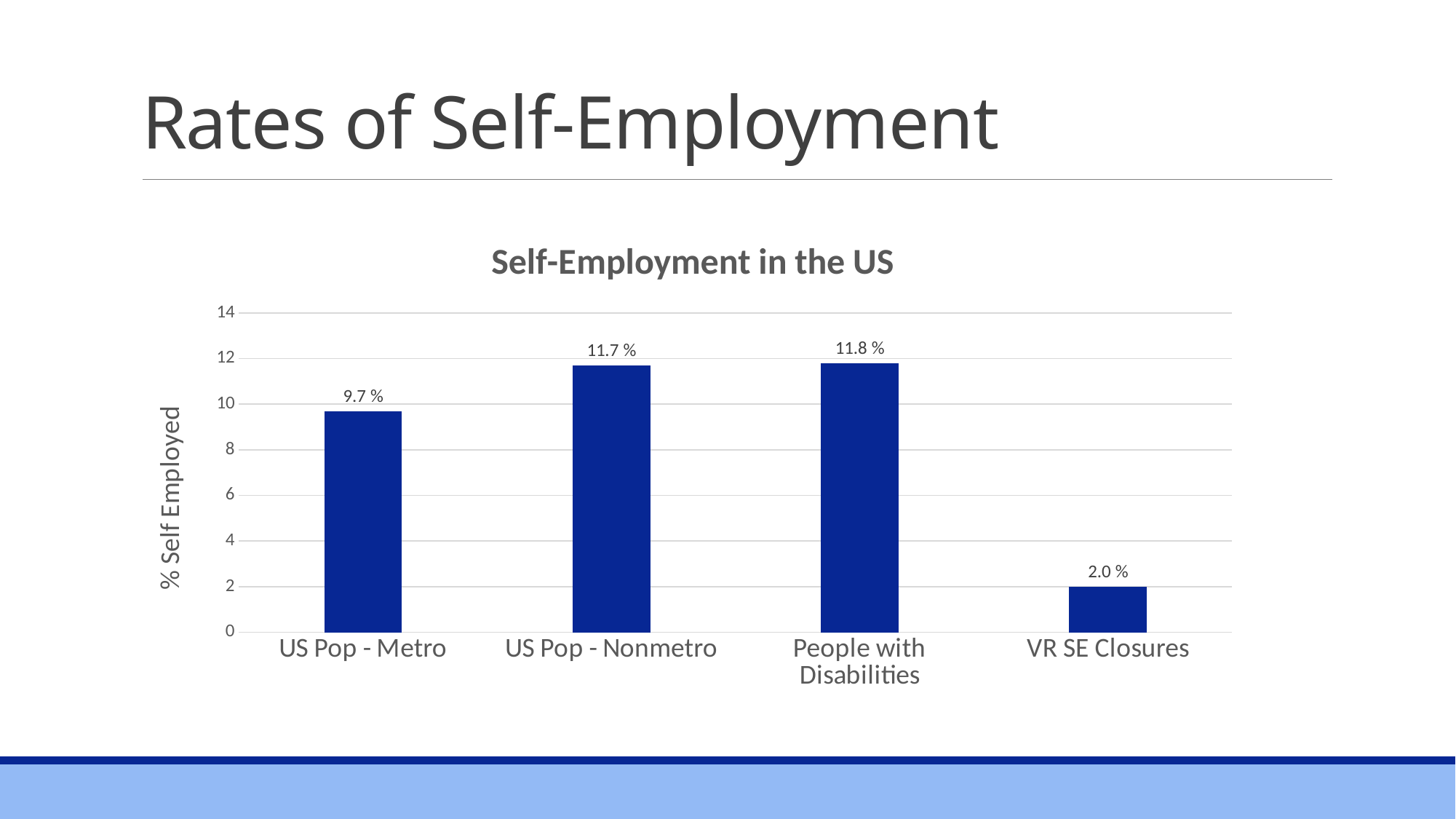
What is the value for People with Disabilities in the Self-Employment in the US chart? 11.8 % Which is larger, the value for US Pop - Metro or the value for US Pop - Nonmetro? US Pop - Nonmetro Which category has the lowest value in the Self-Employment in the US chart? VR SE Closures What kind of chart is shown on the slide? bar chart What is the value for VR SE Closures in the Self-Employment in the US chart? 2.0 % Is the value for VR SE Closures greater or less than 4? less What is the difference between the values for US Pop - Nonmetro and US Pop - Metro? 2.0 % How many categories are shown in the Self-Employment in the US chart? 4 What is the value for US Pop - Metro in the Self-Employment in the US chart? 9.7 % Which category has the highest value in the Self-Employment in the US chart? People with Disabilities What is the label on the vertical axis of the chart? % Self Employed What is the difference between the values for US Pop - Metro and VR SE Closures? 7.7 %